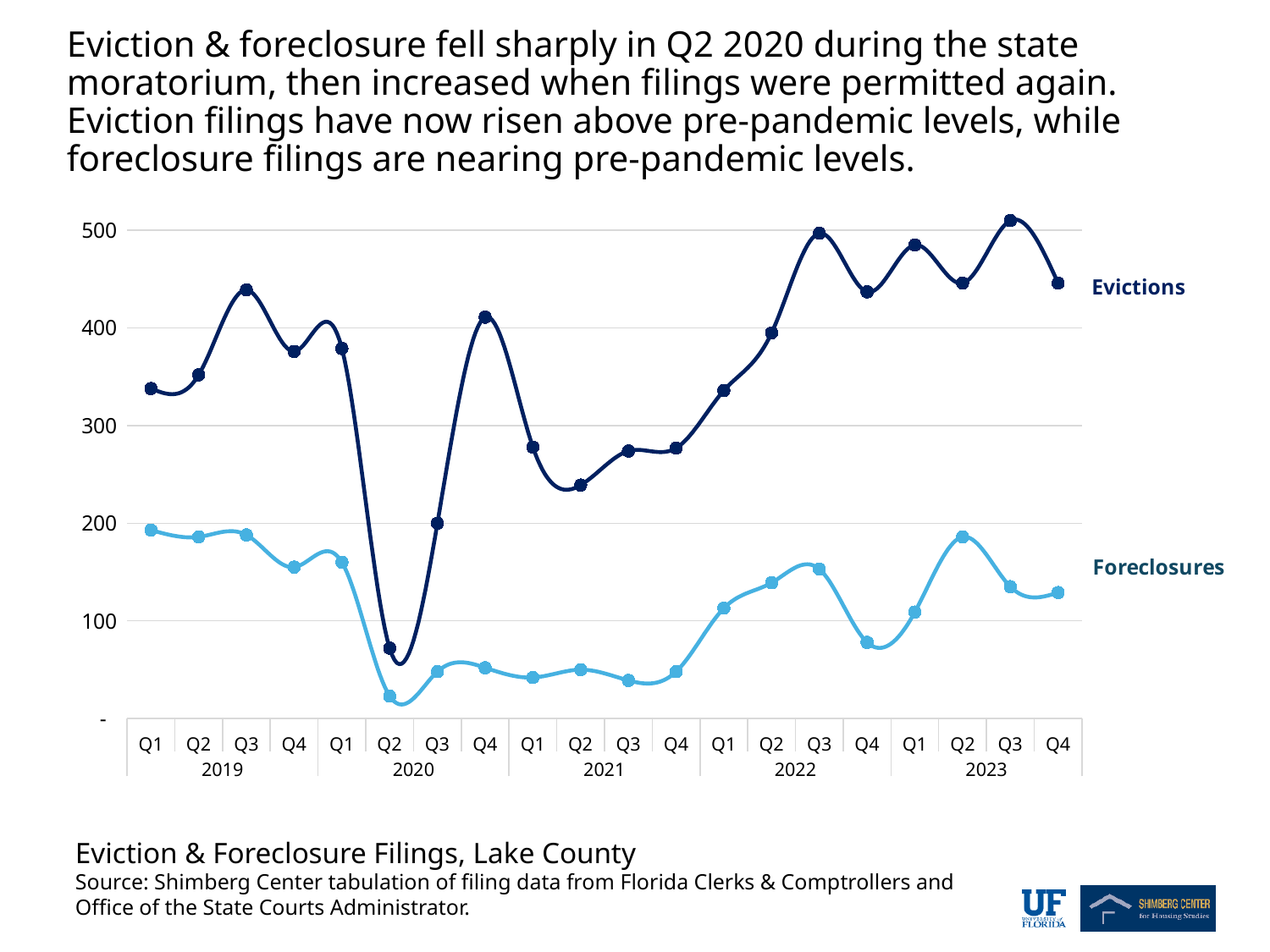
How many quarterly data points does each line have? 20 Which is larger in Q1 2019, Evictions or Foreclosures? Evictions In which quarter is the Evictions value lowest? Q2 2020 What kind of chart is shown on the slide? line chart Is the Evictions value for Q3 2023 greater or less than 500? greater In which quarter is the Foreclosures value lowest? Q2 2020 Is the Foreclosures value for Q4 2022 greater or less than 100? less What is the title of the chart? Eviction & Foreclosure Filings, Lake County Is the Evictions value for Q3 2019 greater or less than 400? greater Do Foreclosures rise or fall from Q1 2019 to Q2 2020? fall How many series are plotted on the chart? 2